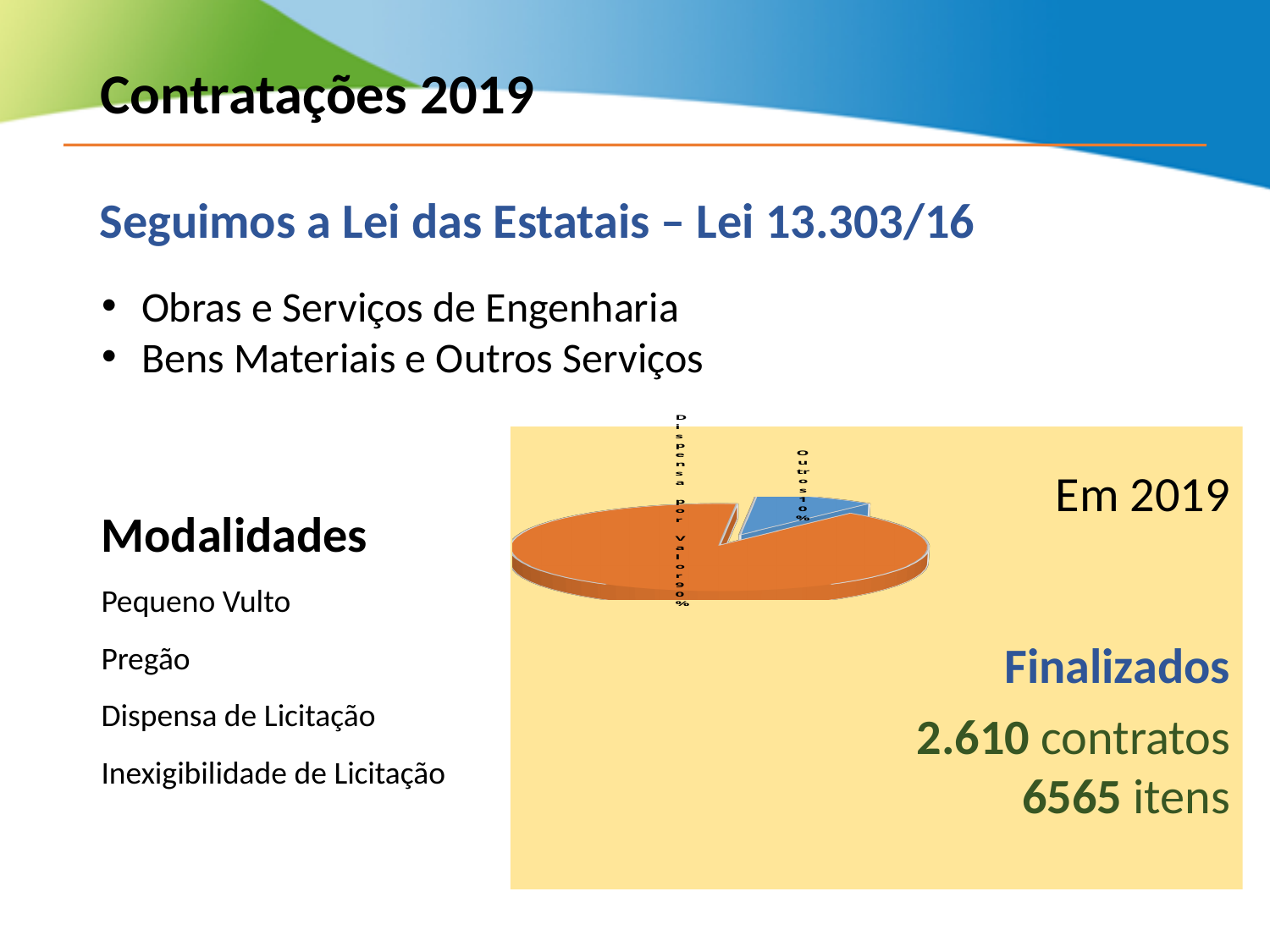
What percentage is shown for the 'Outros' slice of the pie chart? 10% Which slice of the pie chart is the largest? Dispensa por Valor What colour is the 'Dispensa por Valor' slice in the pie chart? orange How many slices does the pie chart have? 2 What share of the pie does the 'Dispensa por Valor' slice represent? 90% Which slice of the pie chart is the smallest? Outros What is the difference in percentage points between the 'Dispensa por Valor' slice and the 'Outros' slice? 80 Which is larger in the pie chart, 'Dispensa por Valor' or 'Outros'? Dispensa por Valor What colour is the 'Outros' slice in the pie chart? blue What kind of chart is shown on the slide? pie chart What share of the pie does the 'Outros' slice represent? 10% What percentage is shown for the 'Dispensa por Valor' slice of the pie chart? 90%